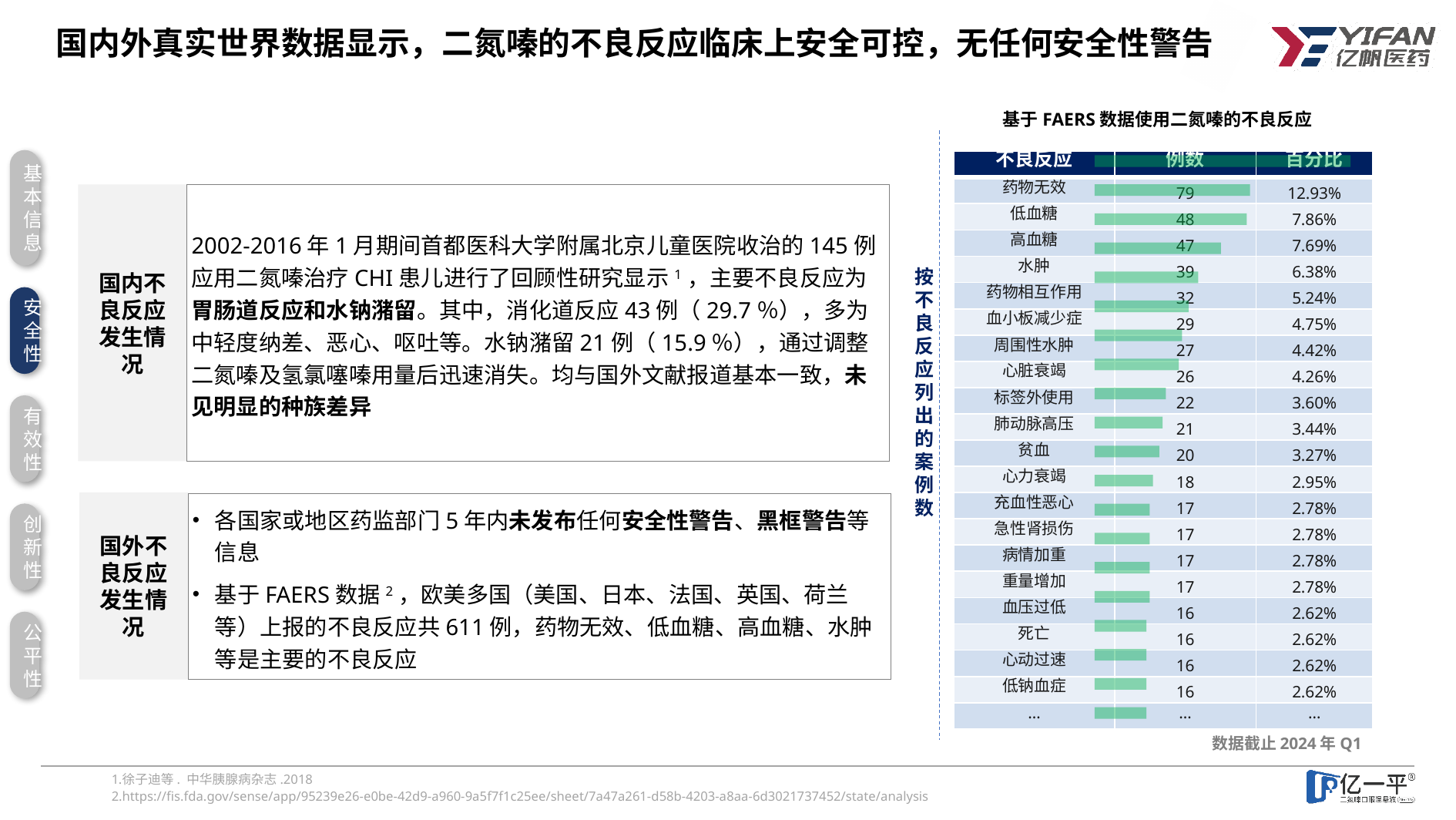
What kind of chart is used in the 基于 FAERS 数据使用二氮嗪的不良反应 panel to show the case counts? Bar chart In the chart titled 基于 FAERS 数据使用二氮嗪的不良反应, what is the difference in case counts between 药物无效 and 低血糖? 31 In the chart titled 基于 FAERS 数据使用二氮嗪的不良反应, how many cases are listed for 水肿? 39 In the chart titled 基于 FAERS 数据使用二氮嗪的不良反应, how many cases (例数) are listed for 药物无效? 79 In the chart titled 基于 FAERS 数据使用二氮嗪的不良反应, what is the data cutoff date noted below the chart? 2024 年 Q1 In the chart titled 基于 FAERS 数据使用二氮嗪的不良反应, how many named adverse reactions are listed (excluding the '...' row)? 20 In the chart titled 基于 FAERS 数据使用二氮嗪的不良反应, what is the difference in case counts between 高血糖 and 水肿? 8 In the chart titled 基于 FAERS 数据使用二氮嗪的不良反应, which has more cases, 血小板减少症 or 贫血? 血小板减少症 In the chart titled 基于 FAERS 数据使用二氮嗪的不良反应, which has a higher percentage, 心脏衰竭 or 心力衰竭? 心脏衰竭 In the chart titled 基于 FAERS 数据使用二氮嗪的不良反应, what percentage is shown for 肺动脉高压? 3.44% In the chart titled 基于 FAERS 数据使用二氮嗪的不良反应, which adverse reaction has the highest number of cases? 药物无效 In the chart titled 基于 FAERS 数据使用二氮嗪的不良反应, what percentage (百分比) is shown for 低血糖? 7.86%